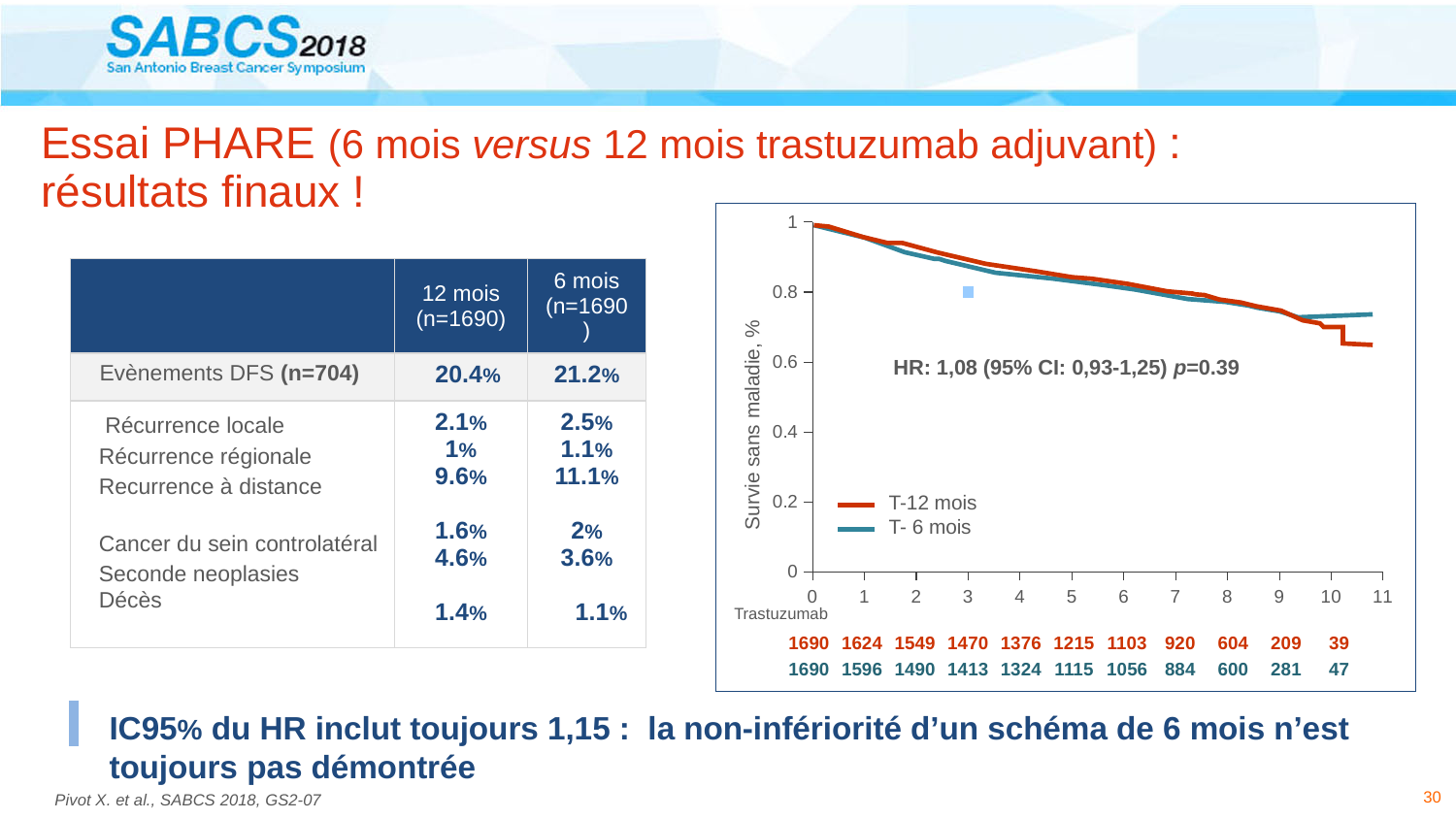
In the numbers at risk below the survival chart, what is the difference between the T- 6 mois and T-12 mois numbers at time 10? 8 What hazard ratio is printed on the survival chart? HR: 1,08 (95% CI: 0,93-1,25) p=0.39 Do the survival curves rise or fall as time increases along the x axis? fall In the numbers at risk below the survival chart, how many T-12 mois patients are at risk at time 5? 1215 What kind of chart is shown on the right of the slide? line chart Is the value of the T-12 mois curve at time 5 greater or less than 0.8? greater Is the value of the T-12 mois curve at time 10 greater or less than 0.8? less In the numbers at risk below the survival chart, which group has more patients at risk at time 9, T-12 mois or T- 6 mois? T- 6 mois How many series does the legend of the survival chart list? 2 What is the label of the y axis of the survival chart? Survie sans maladie, % In the numbers at risk below the survival chart, how many T- 6 mois patients are at risk at time 7? 884 What are the two series named in the legend of the survival chart? T-12 mois and T- 6 mois